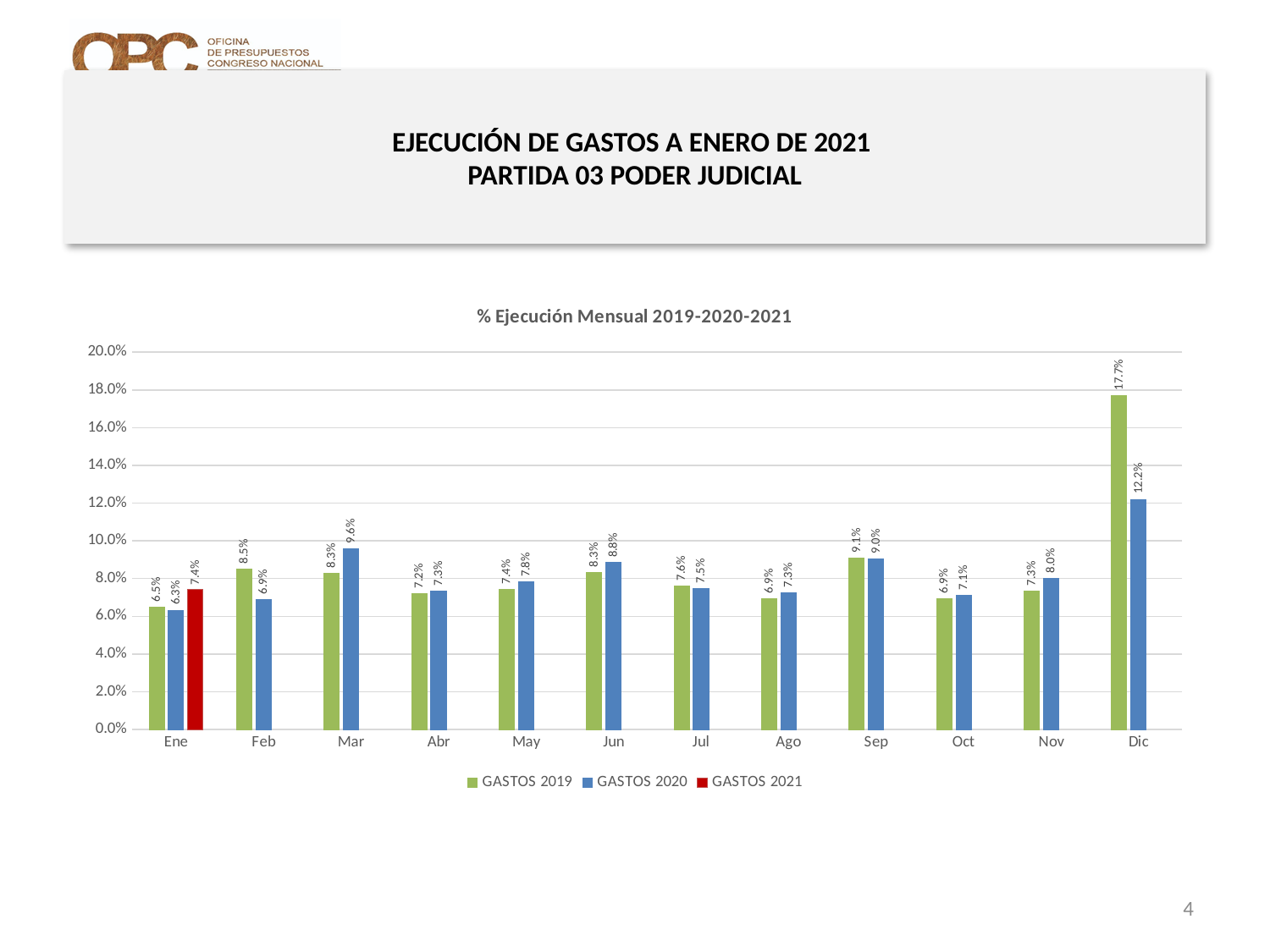
What kind of chart is shown on the slide? Bar chart Which month has the highest value for GASTOS 2020? Dic Which is larger in Feb, GASTOS 2019 or GASTOS 2020? GASTOS 2019 Is the value for GASTOS 2020 in Dic greater or less than 10.0%? greater Which month has the lowest value for GASTOS 2020? Ene How many months are shown on the x axis? 12 What is the title of the chart? % Ejecución Mensual 2019-2020-2021 What is the value for GASTOS 2019 in Dic? 17.7% What is the value for GASTOS 2021 in Ene? 7.4% How many series does the legend list? 3 What is the difference between GASTOS 2019 and GASTOS 2020 in Dic? 5.5% What is the value for GASTOS 2020 in Mar? 9.6%